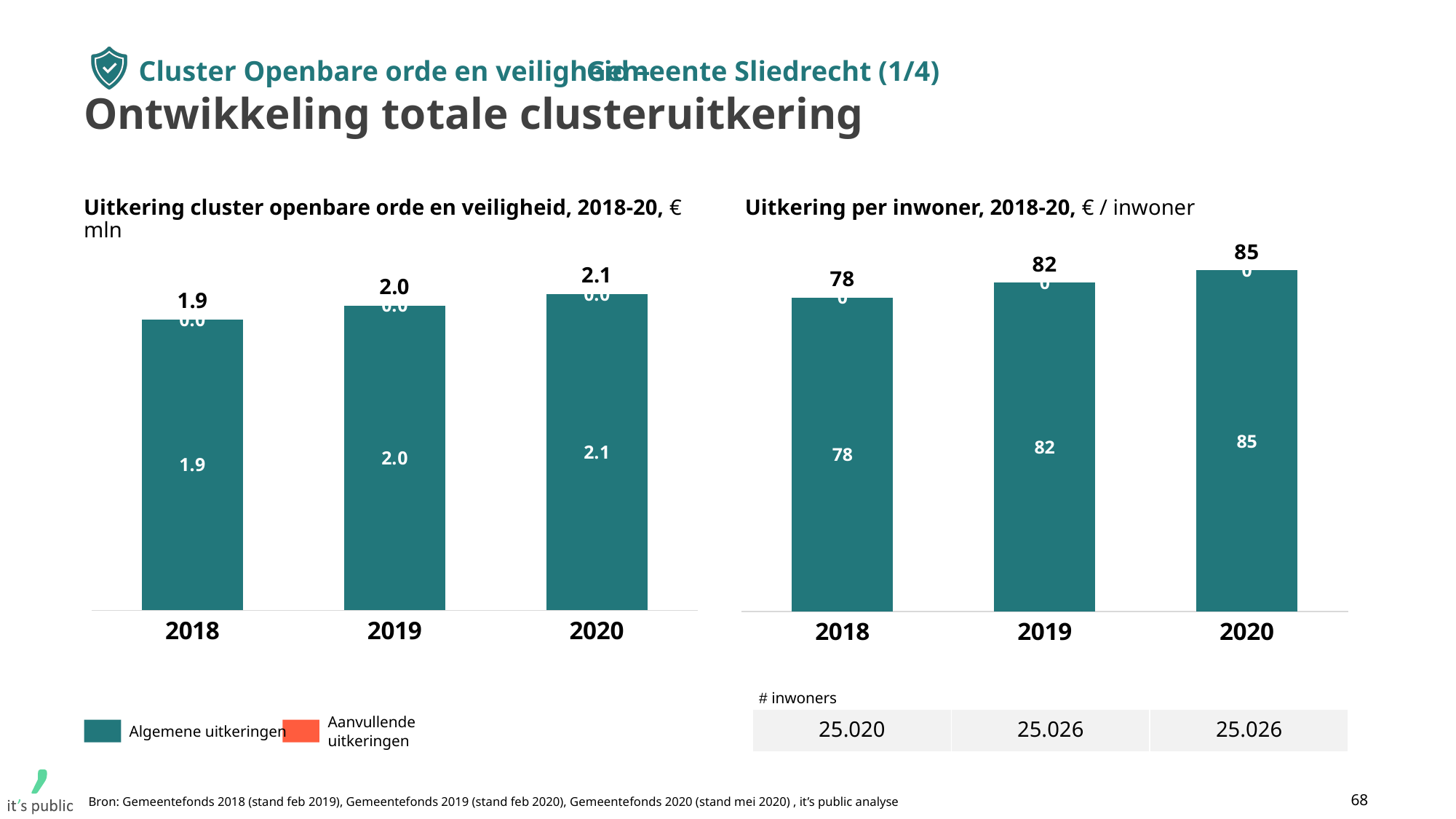
In the right chart (Uitkering per inwoner), what is the difference between the 2020 and 2018 values? 7 In the left chart (Uitkering cluster openbare orde en veiligheid), what is the total value for 2018? 1.9 In the left chart (Uitkering cluster openbare orde en veiligheid), which year has the lowest total? 2018 How many series does the legend on the slide list? 2 What kind of chart is the right chart (Uitkering per inwoner)? Bar chart In the right chart (Uitkering per inwoner), do the values rise or fall from 2018 to 2020? Rise In the left chart (Uitkering cluster openbare orde en veiligheid), what is the difference between the 2020 and 2019 totals? 0.1 In the right chart (Uitkering per inwoner), what is the total value for 2019? 82 In the right chart (Uitkering per inwoner), which year has the highest value? 2020 In the left chart (Uitkering cluster openbare orde en veiligheid), what is the Algemene uitkeringen value for 2020? 2.1 In the right chart (Uitkering per inwoner), is the value for 2019 larger or smaller than the value for 2018? larger How many years are shown on the x axis of the left chart (Uitkering cluster openbare orde en veiligheid)? 3